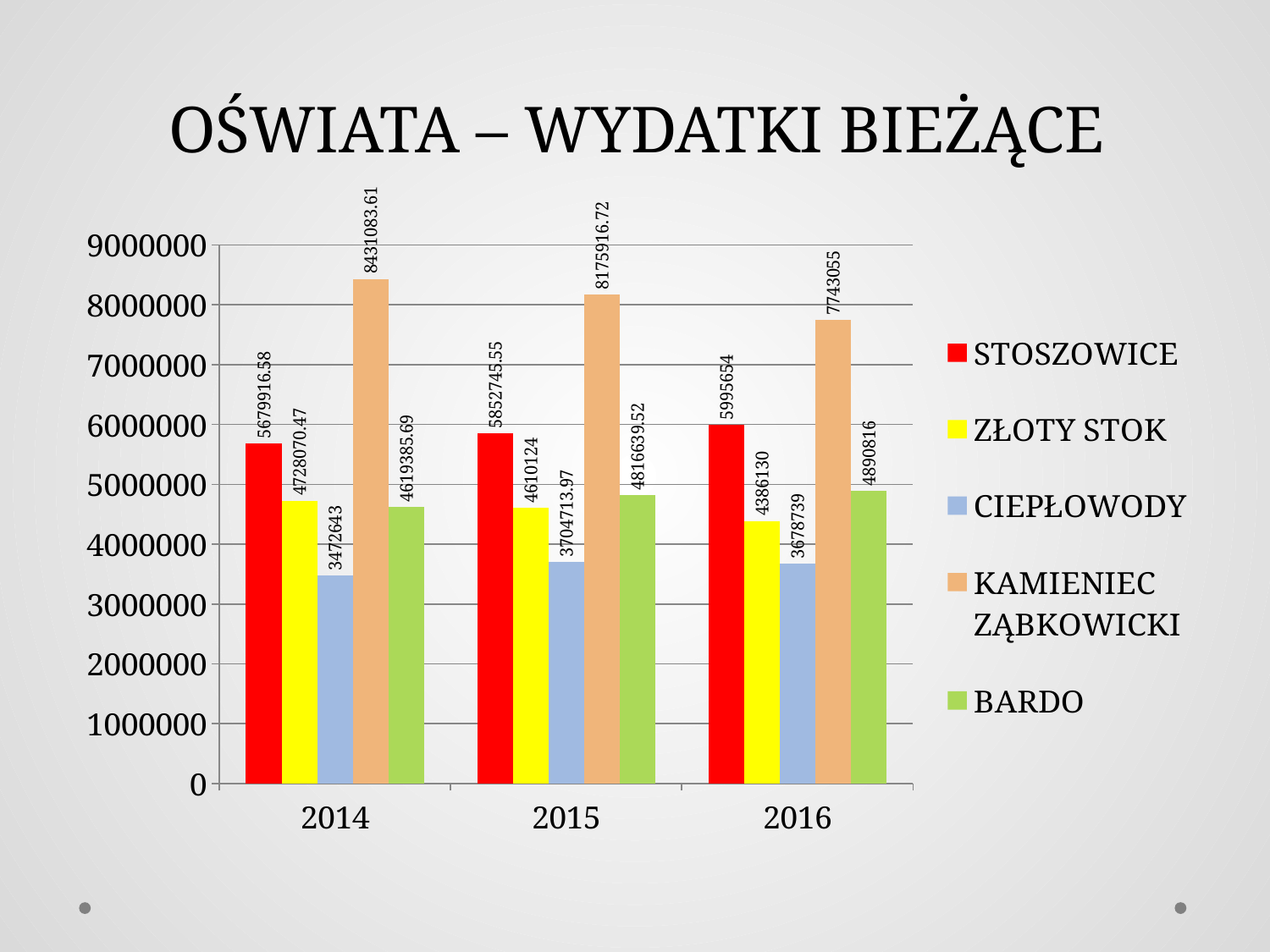
Which is larger in 2015: ZŁOTY STOK or BARDO? BARDO Do the values for KAMIENIEC ZĄBKOWICKI rise or fall from 2014 to 2016? fall Which series has the lowest value in 2016? CIEPŁOWODY What is the value for CIEPŁOWODY in 2015? 3704713.97 What is the value for BARDO in 2015? 4816639.52 Which series has the highest value in 2014? KAMIENIEC ZĄBKOWICKI What kind of chart is shown on the slide? bar chart How many series does the legend list? 5 What is the value for STOSZOWICE in 2014? 5679916.58 What is the value for KAMIENIEC ZĄBKOWICKI in 2016? 7743055 What is the difference between STOSZOWICE and ZŁOTY STOK in 2016? 1609524 Is the value for KAMIENIEC ZĄBKOWICKI in 2015 greater or less than 8000000? greater